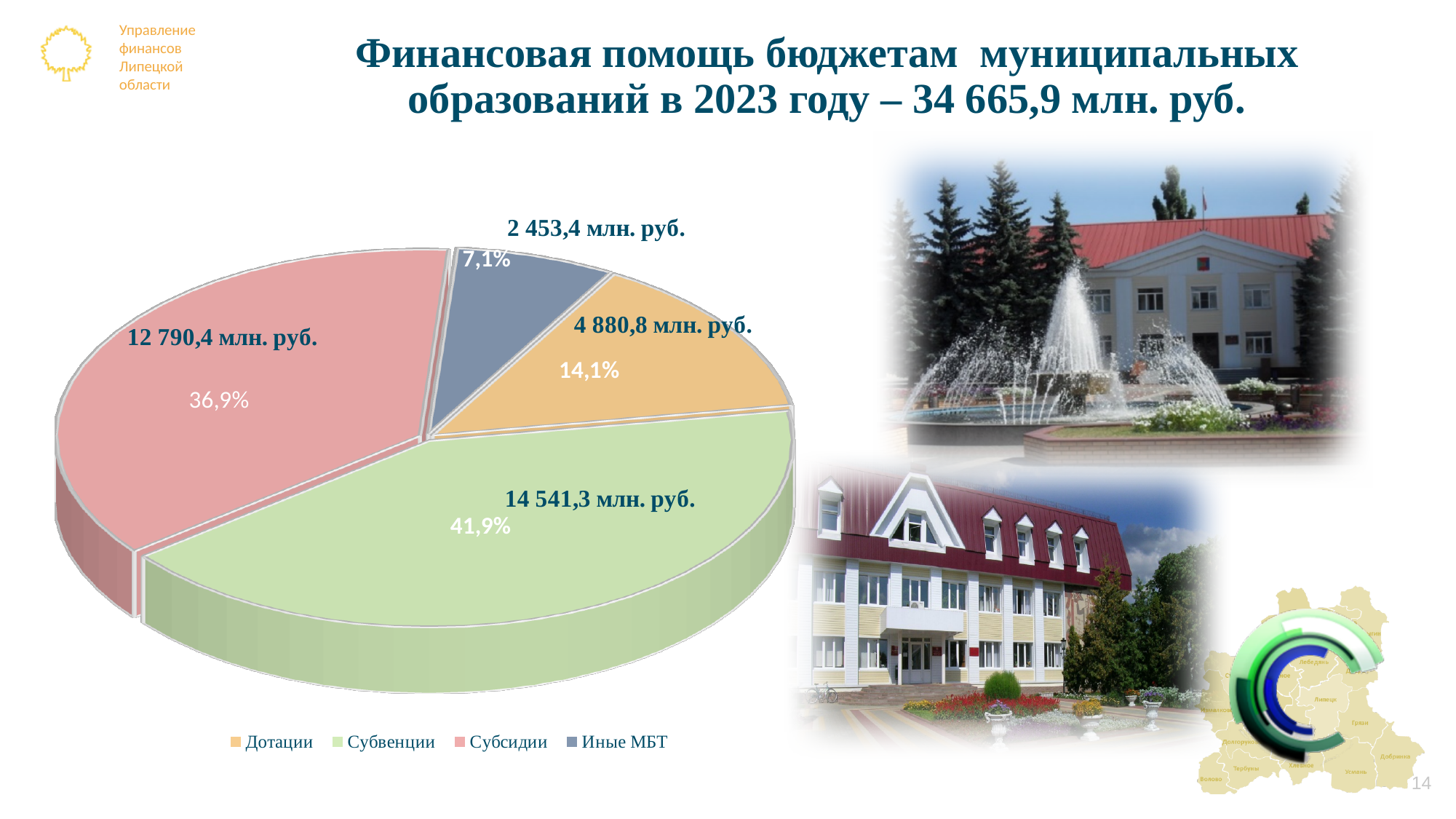
What is the value for Иные МБТ? 2 453,4 млн. руб. What share of the pie does Субсидии take? 36,9% What kind of chart is shown on the slide? pie chart What colour is the Субвенции slice? green What is the difference between the values for Субвенции and Субсидии? 1 750,9 млн. руб. Which category has the smallest slice? Иные МБТ What share of the pie does Иные МБТ take? 7,1% What is the value for Дотации? 4 880,8 млн. руб. How many slices does the pie chart have? 4 What is the value for Субвенции? 14 541,3 млн. руб. Which is larger, Субсидии or Дотации? Субсидии Which category has the largest slice? Субвенции